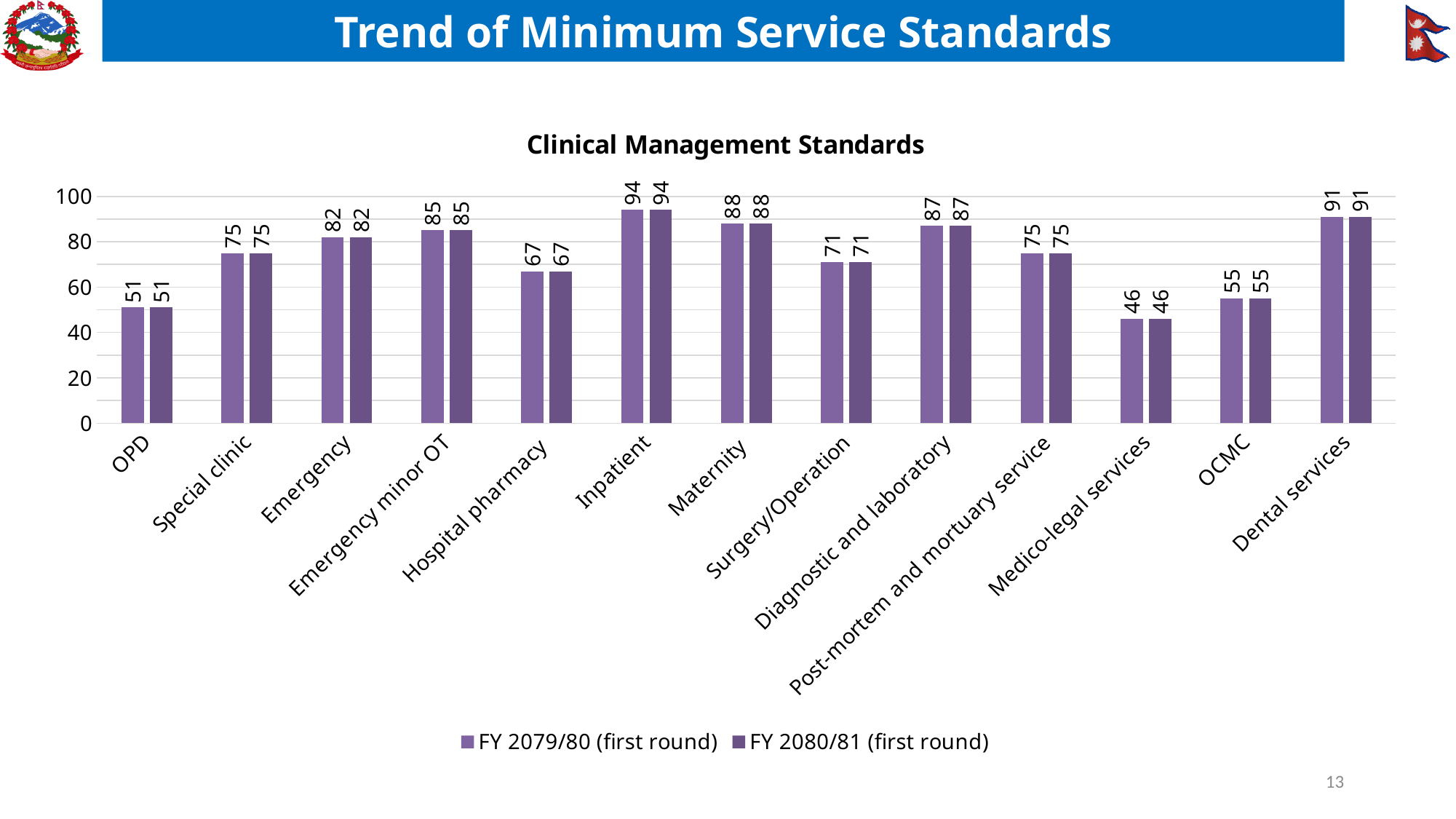
What is the value for Inpatient in FY 2079/80 (first round)? 94 What is the title of the chart? Clinical Management Standards How many series does the legend list? 2 Which category has the highest value in FY 2080/81 (first round)? Inpatient What is the difference between the Dental services and OPD values in FY 2079/80 (first round)? 40 What kind of chart is shown on the slide? Bar chart Which is larger in FY 2080/81 (first round): Emergency or Hospital pharmacy? Emergency How many categories are shown on the x axis? 13 Is the value for Surgery/Operation in FY 2079/80 (first round) greater or less than 80? less What is the value for OCMC in FY 2079/80 (first round)? 55 What is the value for Medico-legal services in FY 2080/81 (first round)? 46 Which category has the lowest value in FY 2079/80 (first round)? Medico-legal services